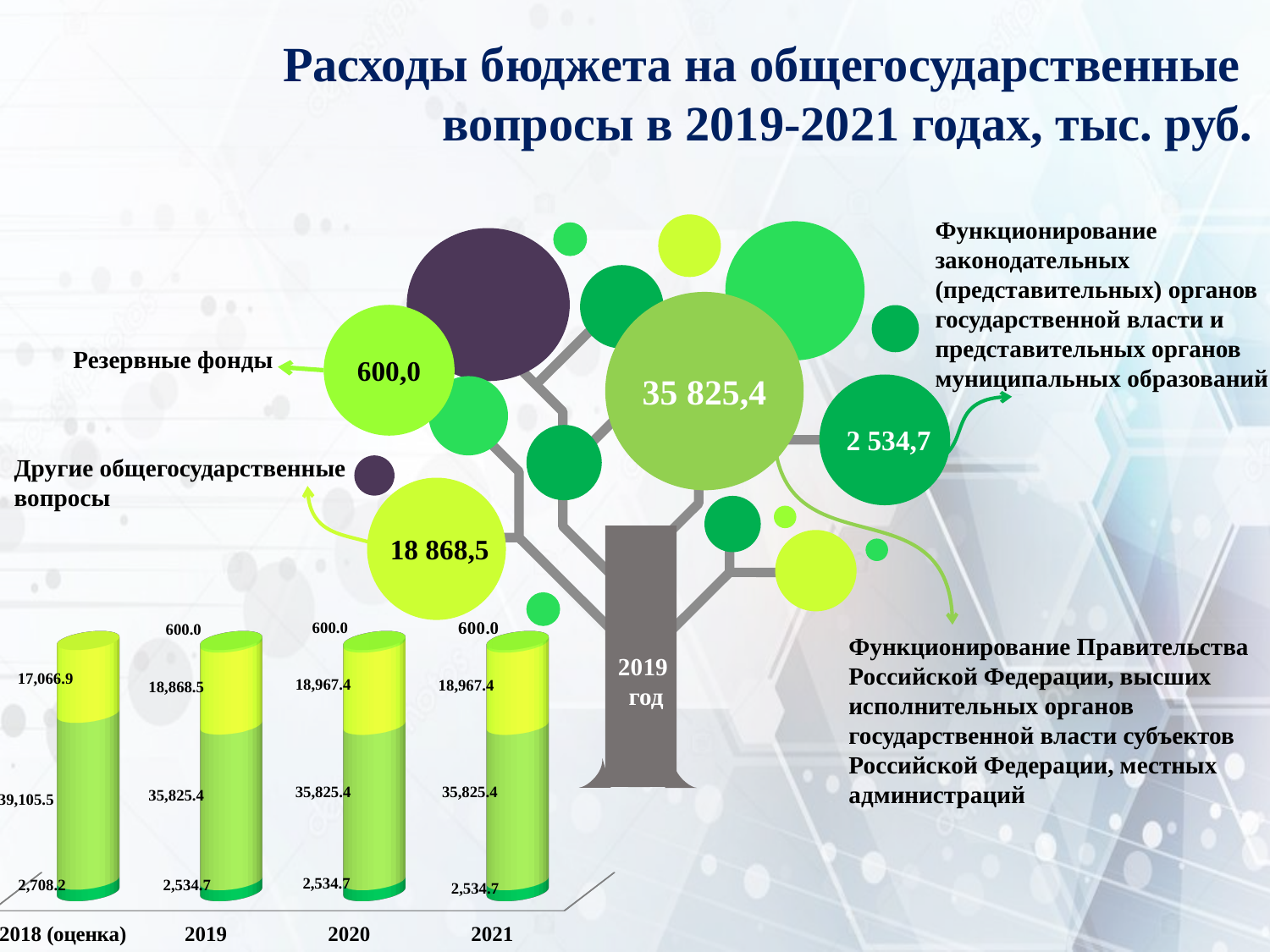
What is the total of the stacked bar for 2019 in the bar chart? 57,828.6 In the bar chart, what is the value of the upper segment for 2020? 18,967.4 What is the difference between the upper segment values for 2020 and 2019 in the bar chart? 98.9 Which year has the lowest value for the upper segment in the bar chart? 2018 (оценка) In the bar chart, what is the value of the topmost segment for 2021? 600.0 What is the difference between the middle segment values for 2018 (оценка) and 2019 in the bar chart? 3,280.1 In the bar chart, what is the value of the bottom segment for 2019? 2,534.7 What kind of chart is shown at the bottom left of the slide? stacked bar chart How many year categories are shown on the x axis of the bar chart? 4 In the bar chart, what is the value of the largest (middle) segment for 2018 (оценка)? 39,105.5 Is the bottom segment value larger for 2018 (оценка) or for 2021 in the bar chart? 2018 (оценка) Which year has the highest value for the middle segment in the bar chart? 2018 (оценка)